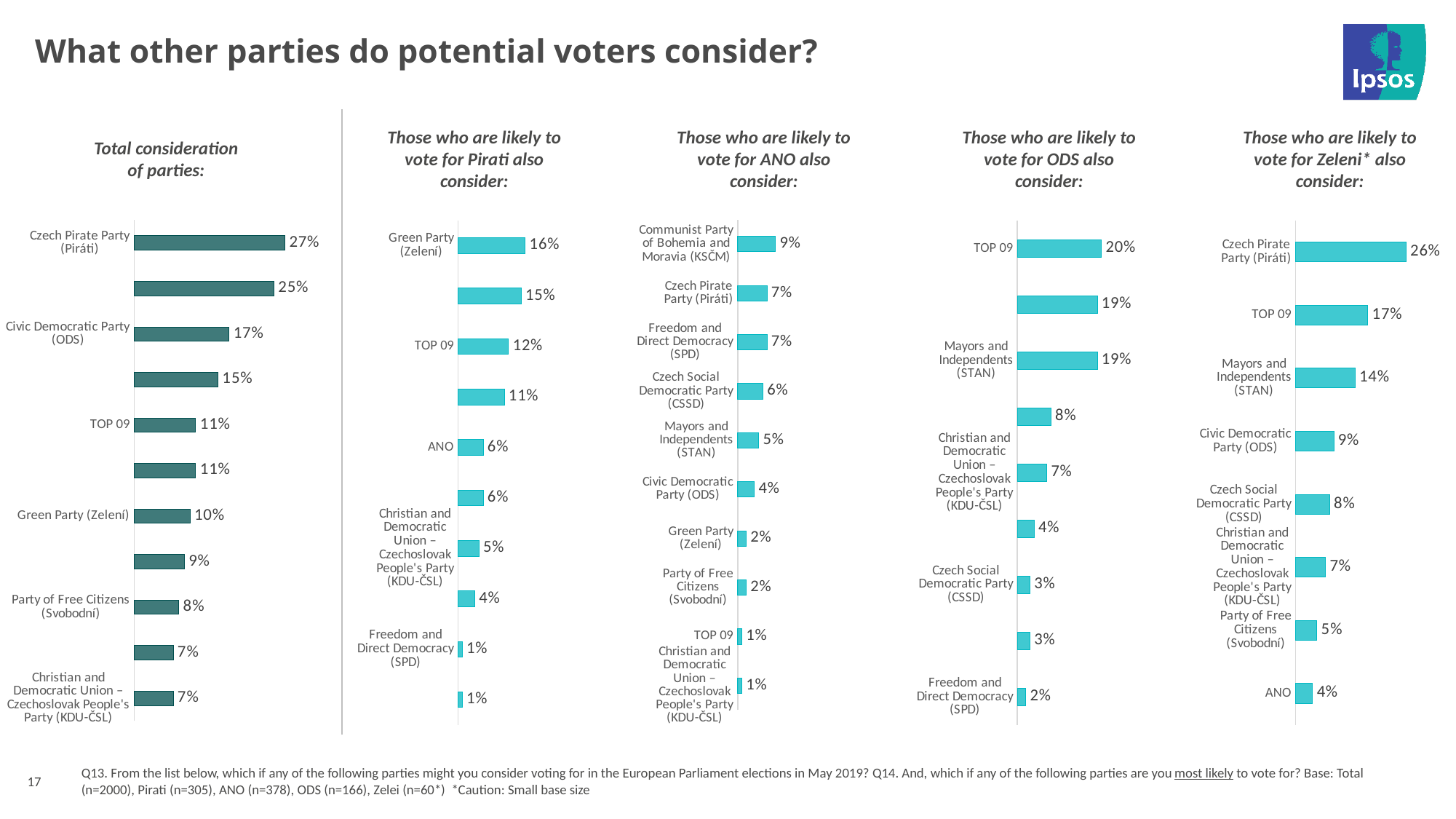
In the 'Those who are likely to vote for Pirati also consider' chart, what is the value for the Green Party (Zelení)? 16% In the 'Those who are likely to vote for ODS also consider' chart, which labelled party has the lowest value? Freedom and Direct Democracy (SPD) In the 'Those who are likely to vote for ODS also consider' chart, what is the value for TOP 09? 20% In the 'Total consideration of parties' chart, which labelled party has the highest value? Czech Pirate Party (Piráti) What type of chart is used on this slide? Bar chart In the 'Those who are likely to vote for ANO also consider' chart, what is the value for the Czech Social Democratic Party (CSSD)? 6% In the 'Total consideration of parties' chart, what is the value for the Czech Pirate Party (Piráti)? 27% In the 'Those who are likely to vote for ANO also consider' chart, which party has the highest value? Communist Party of Bohemia and Moravia (KSČM) In the 'Those who are likely to vote for Pirati also consider' chart, which is larger: TOP 09 or ANO? TOP 09 In the 'Those who are likely to vote for ANO also consider' chart, how many parties are shown? 10 In the 'Total consideration of parties' chart, what is the difference between the Civic Democratic Party (ODS) and the Green Party (Zelení)? 7% In the 'Those who are likely to vote for Zeleni also consider' chart, what is the difference between the Czech Pirate Party (Piráti) and TOP 09? 9%